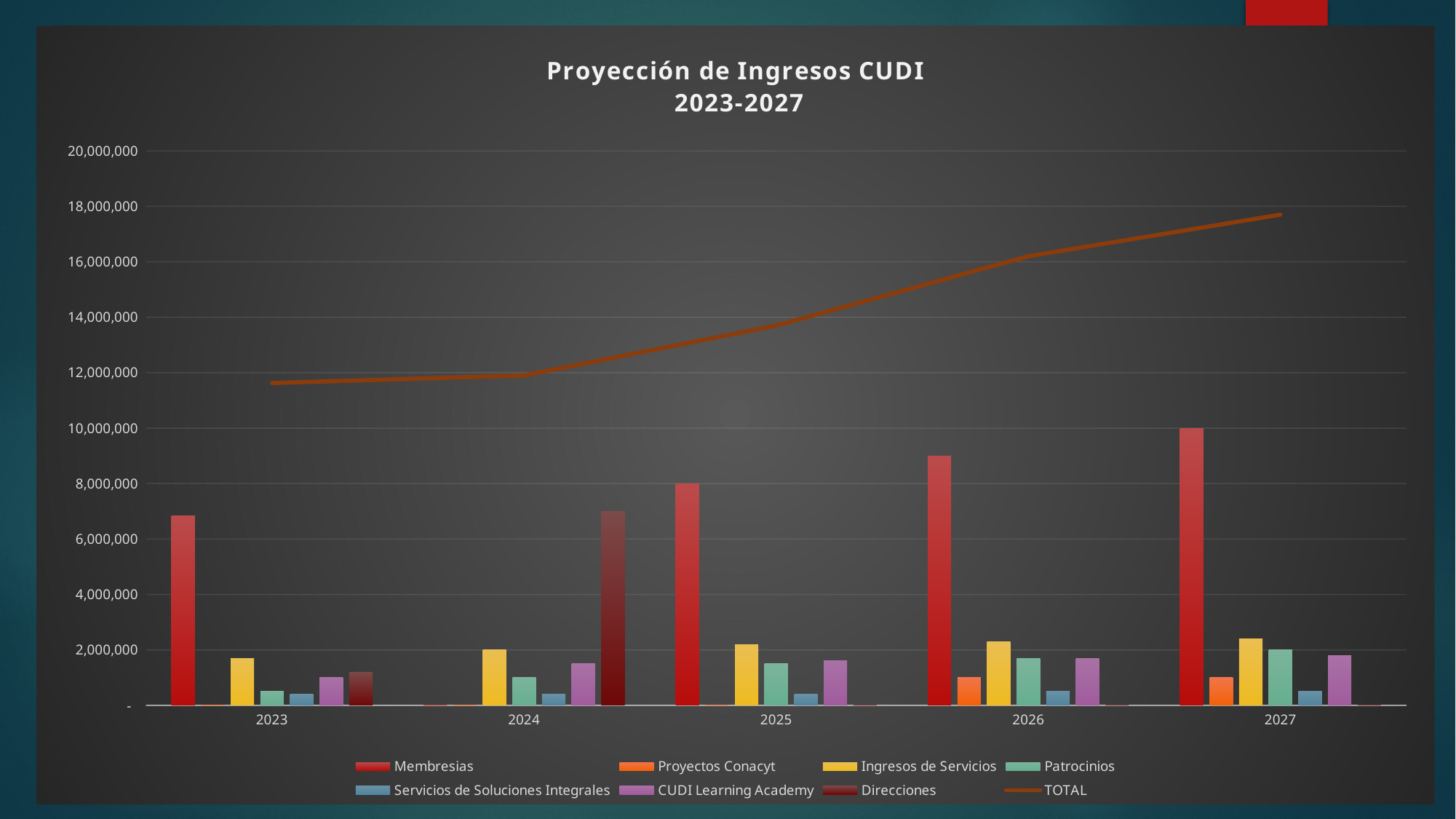
Is the TOTAL value for 2023 greater or less than 12,000,000? less Is the TOTAL value for 2027 greater or less than 16,000,000? greater In which year is the Membresias bar highest? 2027 Which is larger: Membresias in 2026 or Direcciones in 2024? Membresias in 2026 What kind of chart is shown on the slide? bar chart with a line Which series is plotted as a line rather than bars? TOTAL Is the value for Direcciones in 2024 greater or less than 6,000,000? greater How many years are shown on the x axis? 5 How many series does the legend list? 8 Does the TOTAL line rise or fall from 2023 to 2027? rises In which year is the Membresias bar lowest? 2024